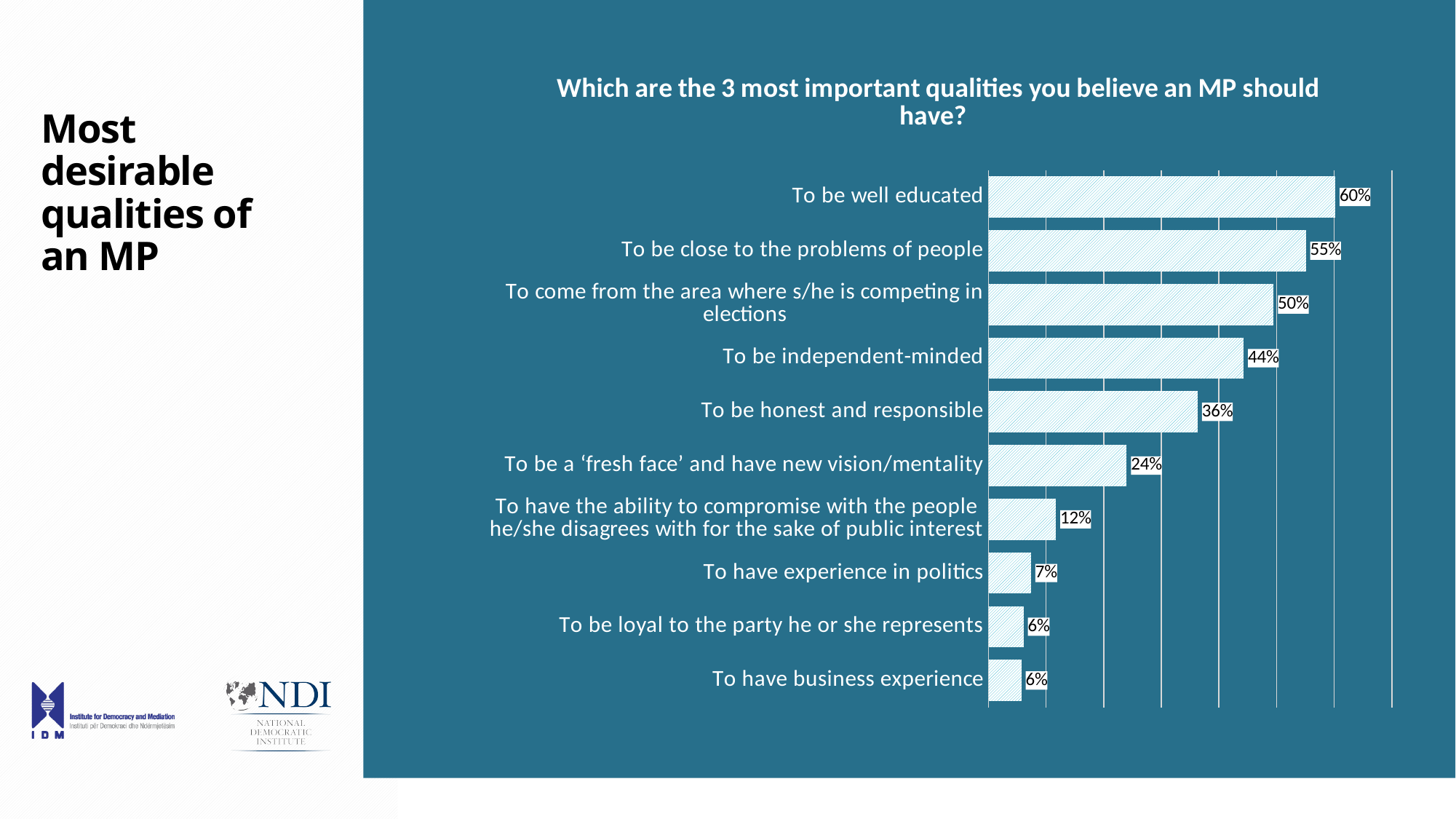
Which quality has the highest percentage in the chart? To be well educated What percentage is shown for "To have the ability to compromise with the people he/she disagrees with for the sake of public interest"? 12% What is the title of the chart? Which are the 3 most important qualities you believe an MP should have? What is the difference between the values for "To be well educated" and "To have business experience"? 54 What percentage of respondents chose "To be well educated" as an important quality for an MP? 60% How many qualities (categories) are listed in the chart? 10 What is the value for "To be independent-minded"? 44% Do the values increase or decrease going from the top bar to the bottom bar? Decrease What type of chart is shown on the slide? Bar chart Which is larger: the value for "To come from the area where s/he is competing in elections" or the value for "To be a 'fresh face' and have new vision/mentality"? To come from the area where s/he is competing in elections Which quality has the lowest percentage, "To have experience in politics" or "To be loyal to the party he or she represents"? To be loyal to the party he or she represents What is the difference in percentage points between "To be close to the problems of people" and "To be honest and responsible"? 19